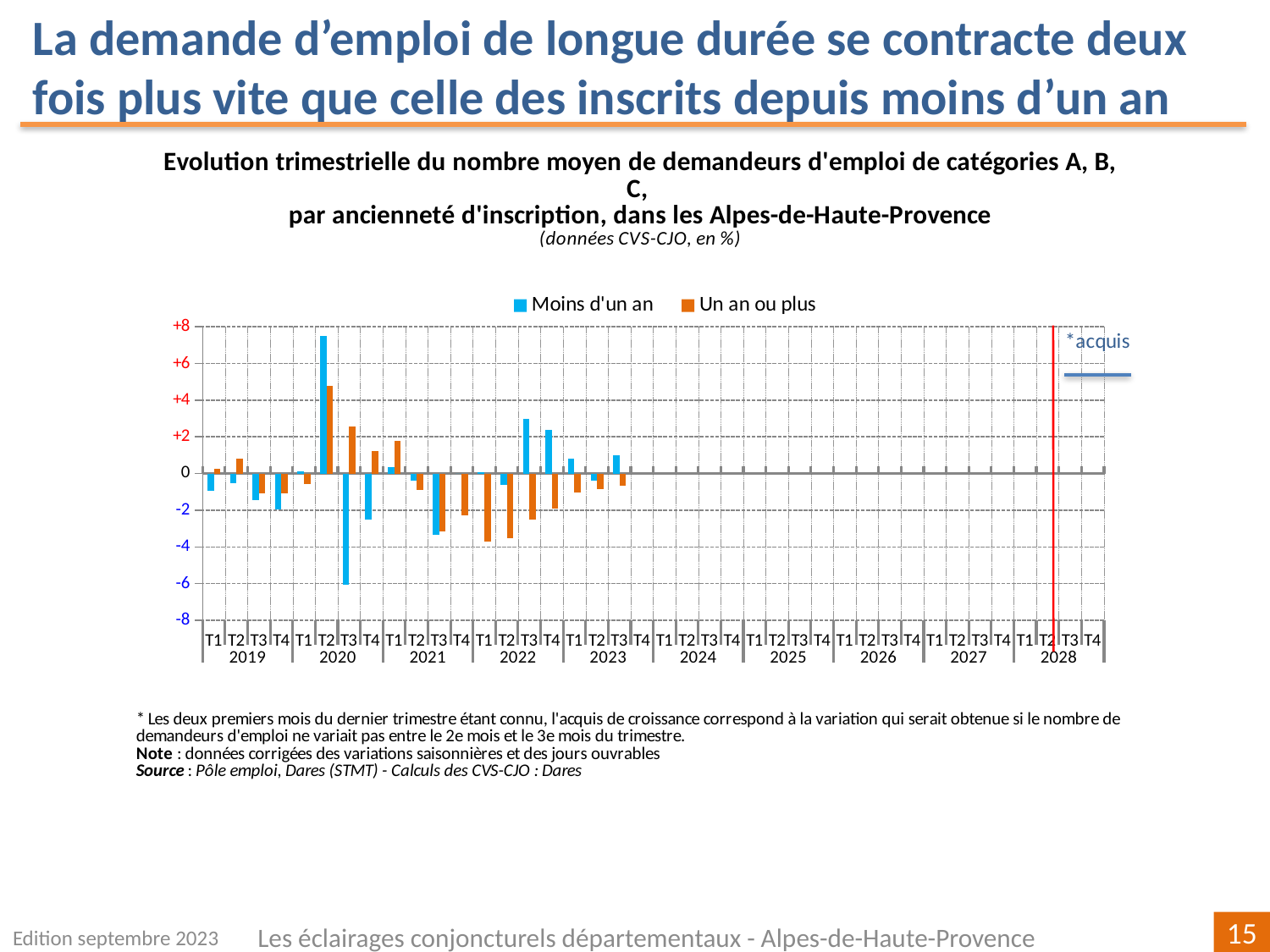
How many years are labelled along the x axis? 10 In which quarter does the 'Moins d'un an' series reach its highest value? T2 2020 Is the value for 'Moins d'un an' in T2 2020 greater or less than +6? greater In which quarter does the 'Un an ou plus' series reach its highest value? T2 2020 In which quarter does the 'Moins d'un an' series reach its lowest value? T3 2020 In T3 2022, which series has the larger value, 'Moins d'un an' or 'Un an ou plus'? Moins d'un an What are the two series named in the legend? Moins d'un an; Un an ou plus Is the value for 'Un an ou plus' in T2 2020 greater or less than +4? greater Is the value for 'Moins d'un an' in T3 2020 greater or less than -4? less What kind of chart is shown on the slide? bar chart How many series does the legend list? 2